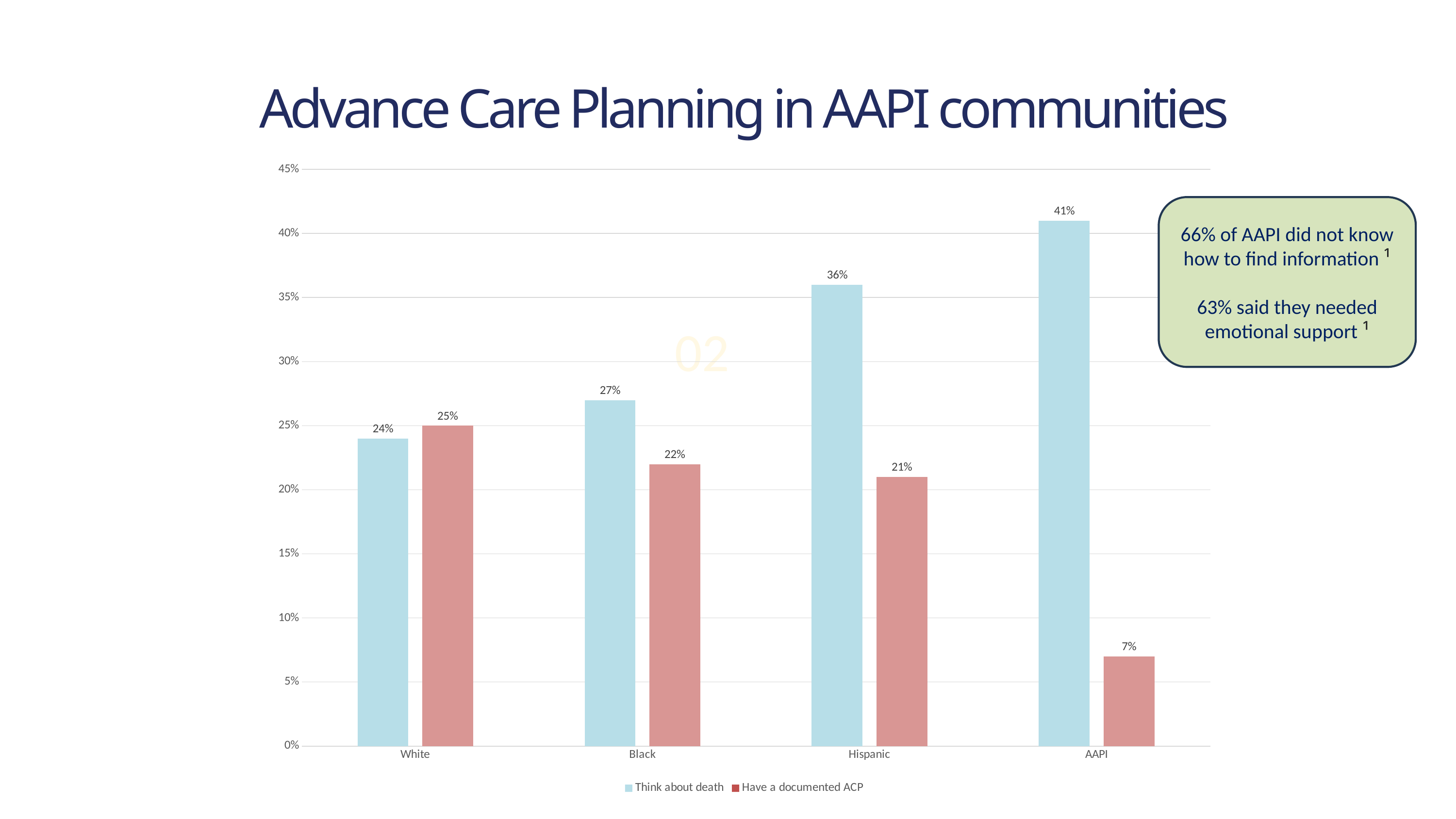
How many series does the legend list? 2 What kind of chart is shown on the slide? Bar chart Which colour represents the 'Have a documented ACP' series? Red What is the value for 'Have a documented ACP' for the White group? 25% How many groups are shown on the x axis? 4 What is the value for 'Think about death' for the AAPI group? 41% Which is larger for the Black group: 'Think about death' or 'Have a documented ACP'? Think about death Which group has the lowest value for 'Have a documented ACP'? AAPI Which group has the highest value for 'Think about death'? AAPI What is the difference between 'Think about death' and 'Have a documented ACP' for the AAPI group? 34% What is the difference between the 'Think about death' values for Hispanic and Black? 9% What is the value for 'Have a documented ACP' for the Hispanic group? 21%